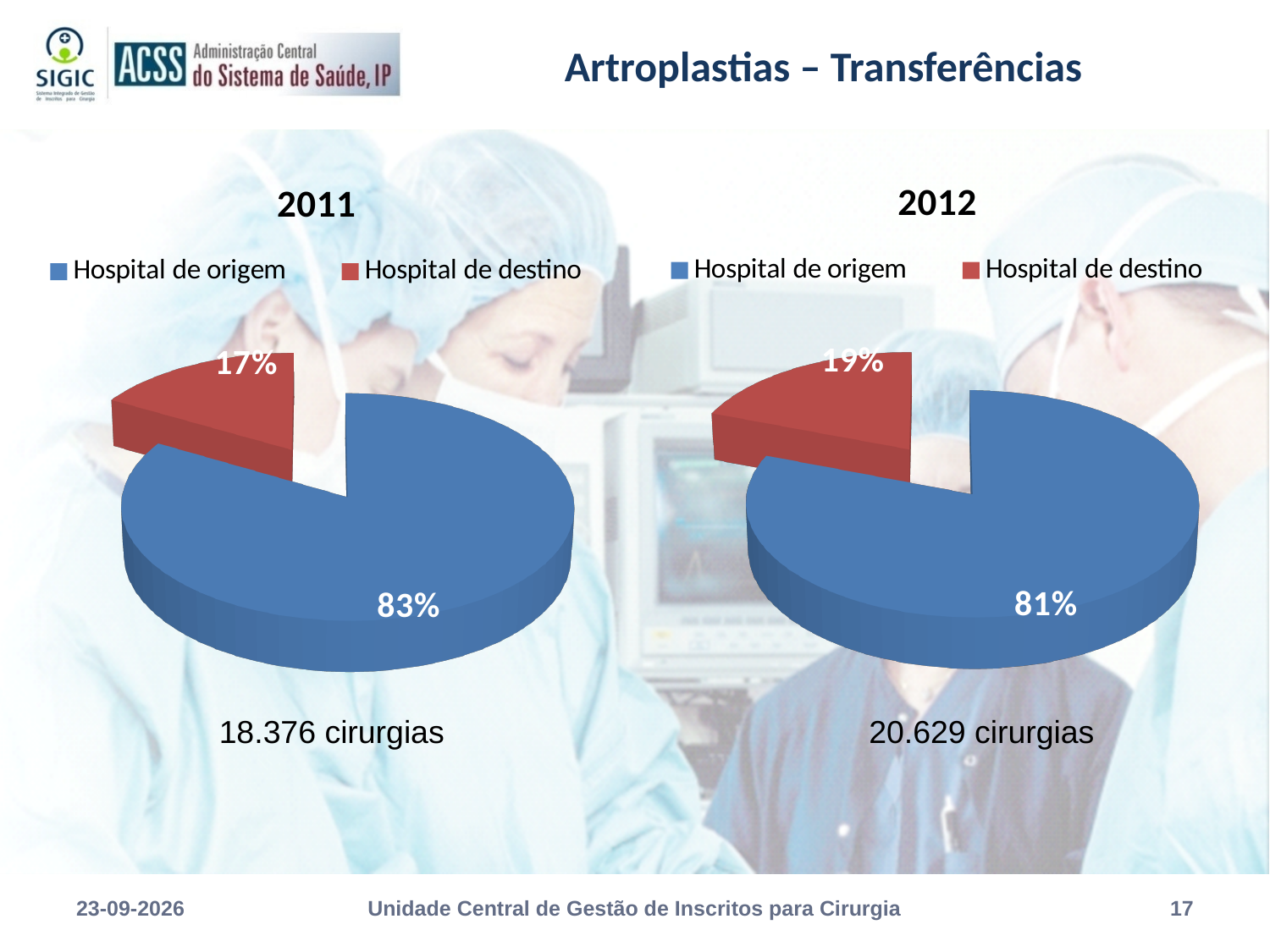
In the 2012 chart, what share of the pie is Hospital de origem? 81% Which is larger: the Hospital de destino share in 2011 or in 2012? 2012 In the 2012 chart, which category has the smallest slice? Hospital de destino In the 2011 chart, what share of the pie is Hospital de origem? 83% In the 2011 chart, which category has the largest slice? Hospital de origem In the 2012 chart, what is the difference in percentage points between Hospital de origem and Hospital de destino? 62 In the 2011 chart, what share of the pie is Hospital de destino? 17% How many entries does the legend of the 2011 chart list? 2 How many categories does the 2012 chart show? 2 In the 2012 chart, what colour is the Hospital de destino slice? Red What kind of chart is the 2011 chart? Pie chart